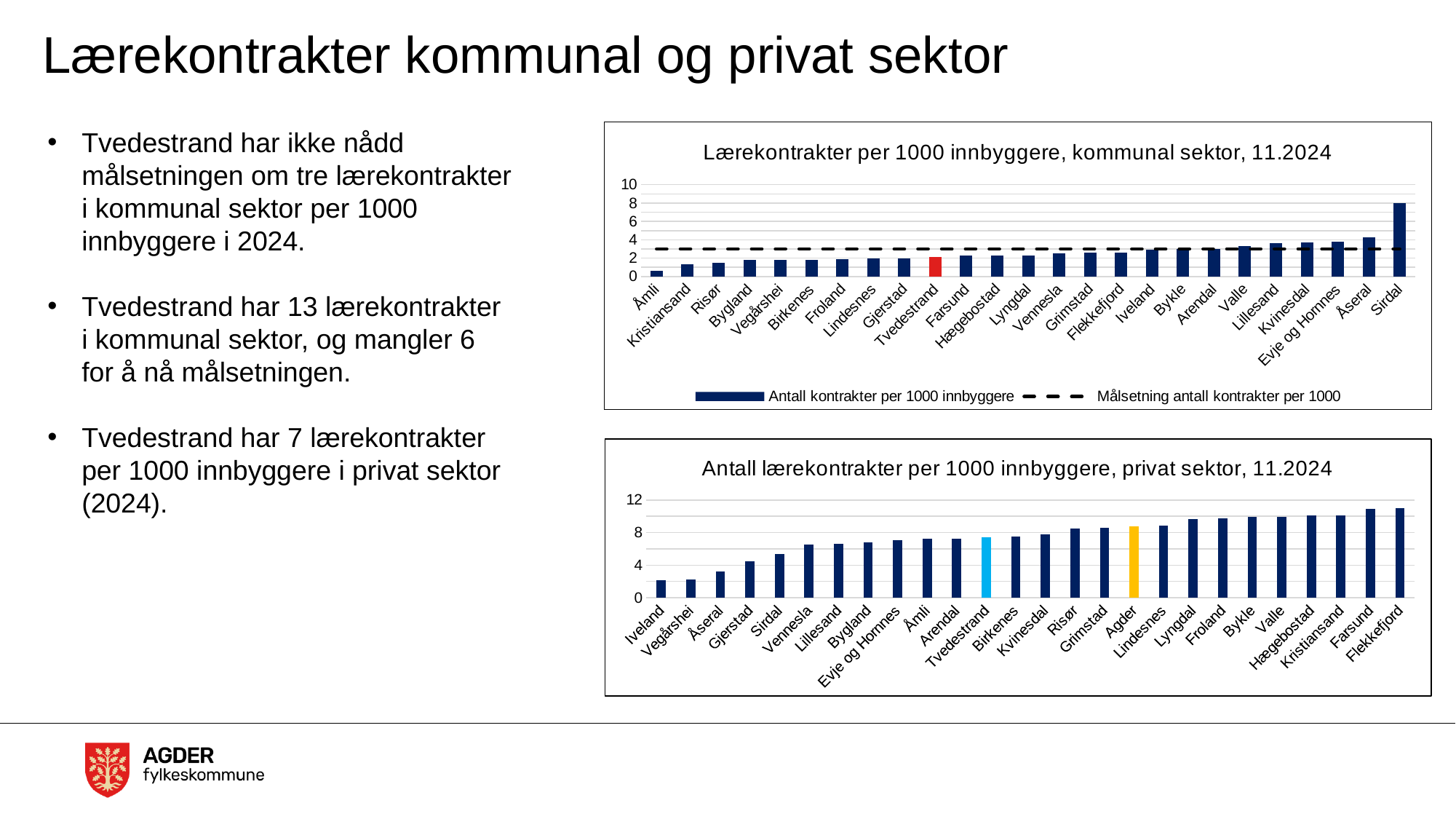
In the top chart (kommunal sektor), is the value for Tvedestrand greater or less than 4? less In the bottom chart (privat sektor), do the values rise or fall from left to right along the x axis? rise In the top chart (kommunal sektor), how many series does the legend list? 2 What kind of chart is the bottom chart (privat sektor)? bar chart In the top chart (kommunal sektor), how many municipalities are shown on the x axis? 25 In the bottom chart (privat sektor), is the value for Flekkefjord greater or less than 8? greater In the bottom chart (privat sektor), is the value for Iveland greater or less than 4? less In the top chart (kommunal sektor), which municipality has the lowest number of lærekontrakter per 1000 innbyggere? Åmli In the top chart (kommunal sektor), which is larger, the value for Sirdal or the value for Kristiansand? Sirdal In the top chart (kommunal sektor), which municipality's bar is coloured red? Tvedestrand In the top chart (kommunal sektor), which municipality has the highest number of lærekontrakter per 1000 innbyggere? Sirdal